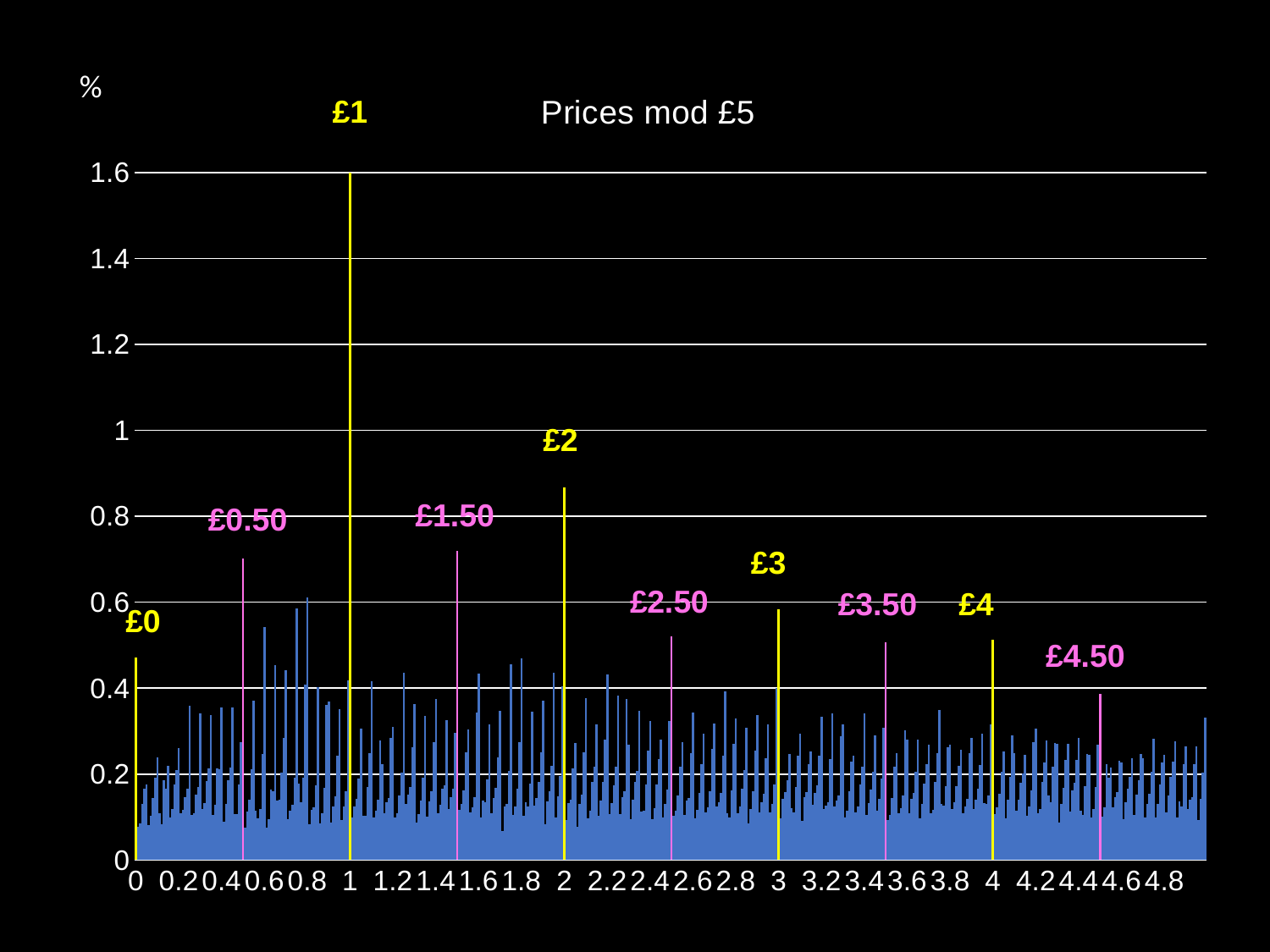
What colour are the bars for the whole-pound prices (£1, £2, £3, £4) highlighted in? yellow What kind of chart is shown on the slide? bar chart Is the value for £0.50 greater or less than 0.8? less What is the title of the chart? Prices mod £5 Is the value for £2.50 greater or less than 0.4? greater Which labelled price has the highest bar in the chart? £1 Which has the larger value, £2 or £4.50? £2 How many price points are highlighted with labels (£0, £0.50, ... £4.50) in the chart? 10 Is the value for £1 greater or less than 1.4? greater Which has the larger value, £1 or £2? £1